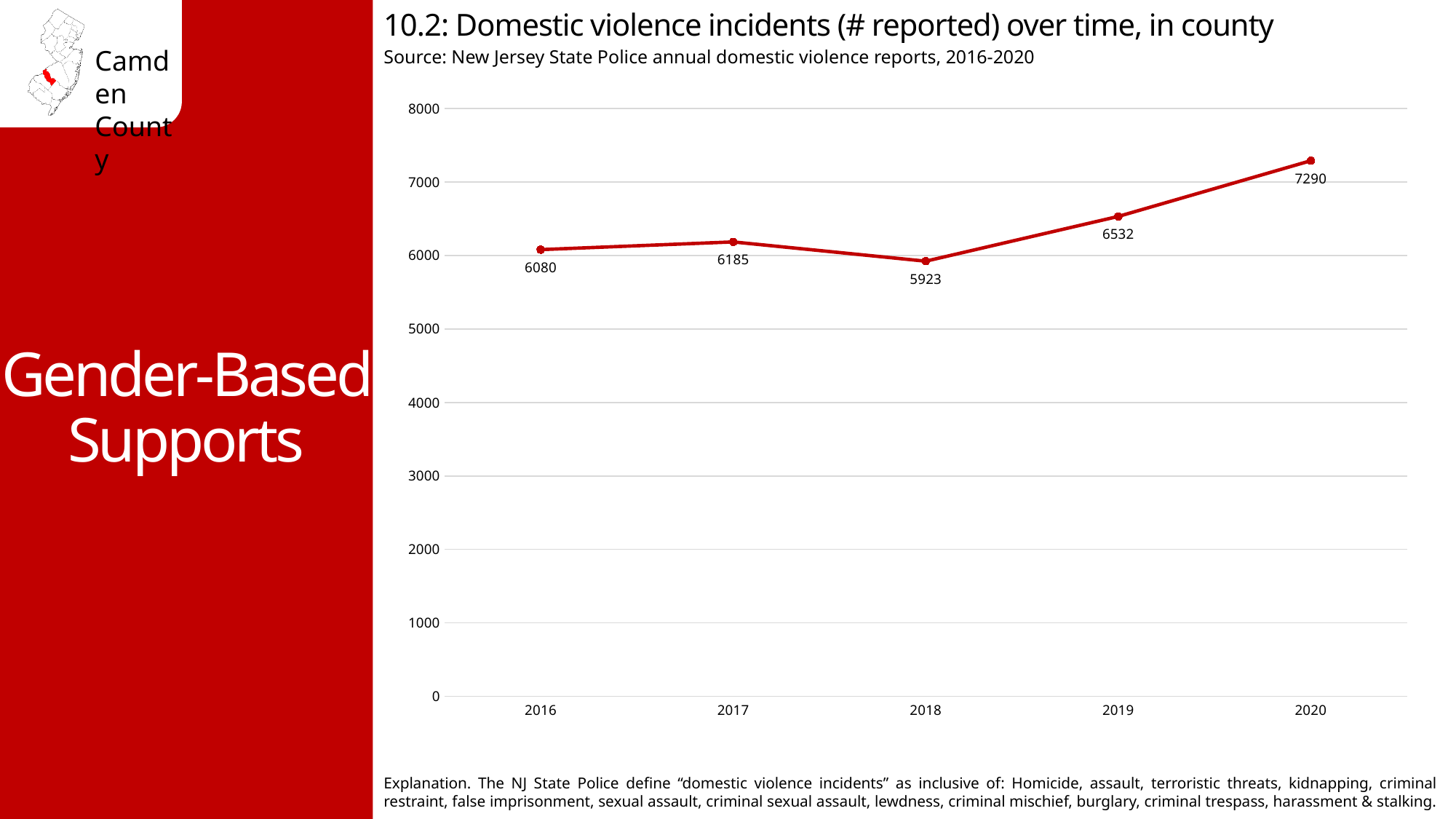
What was the number of reported domestic violence incidents in 2016? 6080 Which year had the highest number of reported domestic violence incidents? 2020 What is the difference between the number of incidents in 2020 and in 2019? 758 What is the difference between the number of incidents in 2017 and in 2018? 262 Which year had the lowest number of reported domestic violence incidents? 2018 Which year had more reported incidents, 2017 or 2019? 2019 How many years are plotted on the chart? 5 Is the value for 2019 greater or less than 6000? greater What was the number of reported domestic violence incidents in 2018? 5923 What kind of chart is shown on the slide? line chart What was the number of reported domestic violence incidents in 2020? 7290 Did the number of reported incidents rise or fall from 2018 to 2020? rise